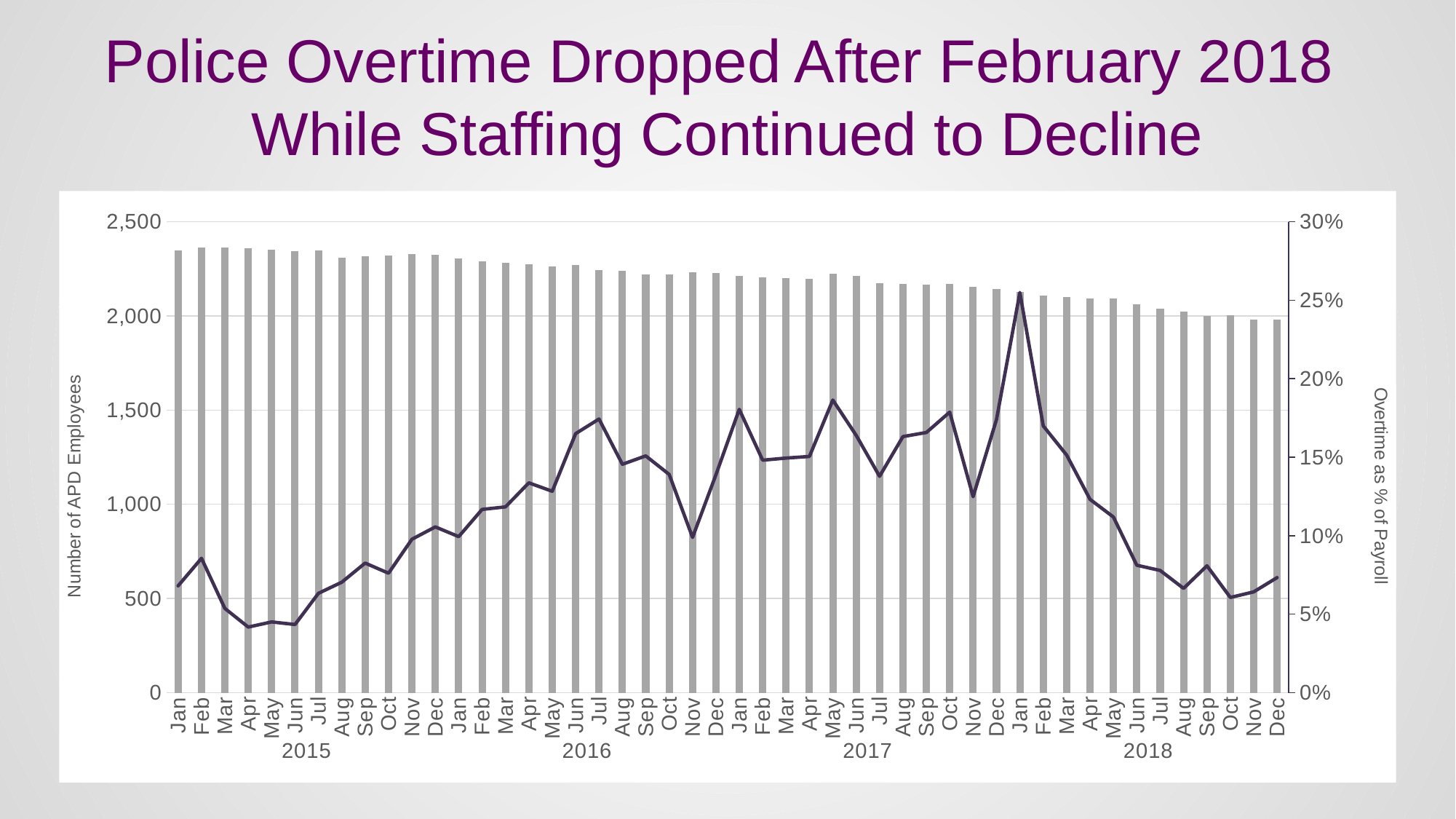
What is the title of the right vertical axis? Overtime as % of Payroll Which is larger, the Number of APD Employees in Jan 2015 or in Dec 2018? Jan 2015 In which month does the Overtime as % of Payroll line reach its highest point? Jan 2018 Is the Overtime as % of Payroll value for Jan 2018 greater or less than 20%? greater Is the Number of APD Employees for Jan 2015 greater or less than 2,000? greater Is the Overtime as % of Payroll value for Apr 2015 greater or less than 5%? less What is the title of the left vertical axis? Number of APD Employees How many monthly data points are plotted along the x axis? 48 What kind of chart is shown on the slide? Combined bar and line chart Do the bars for Number of APD Employees rise or fall from Jan 2015 to Dec 2018? Fall Which is larger, the Overtime as % of Payroll in Jan 2018 or in Jan 2015? Jan 2018